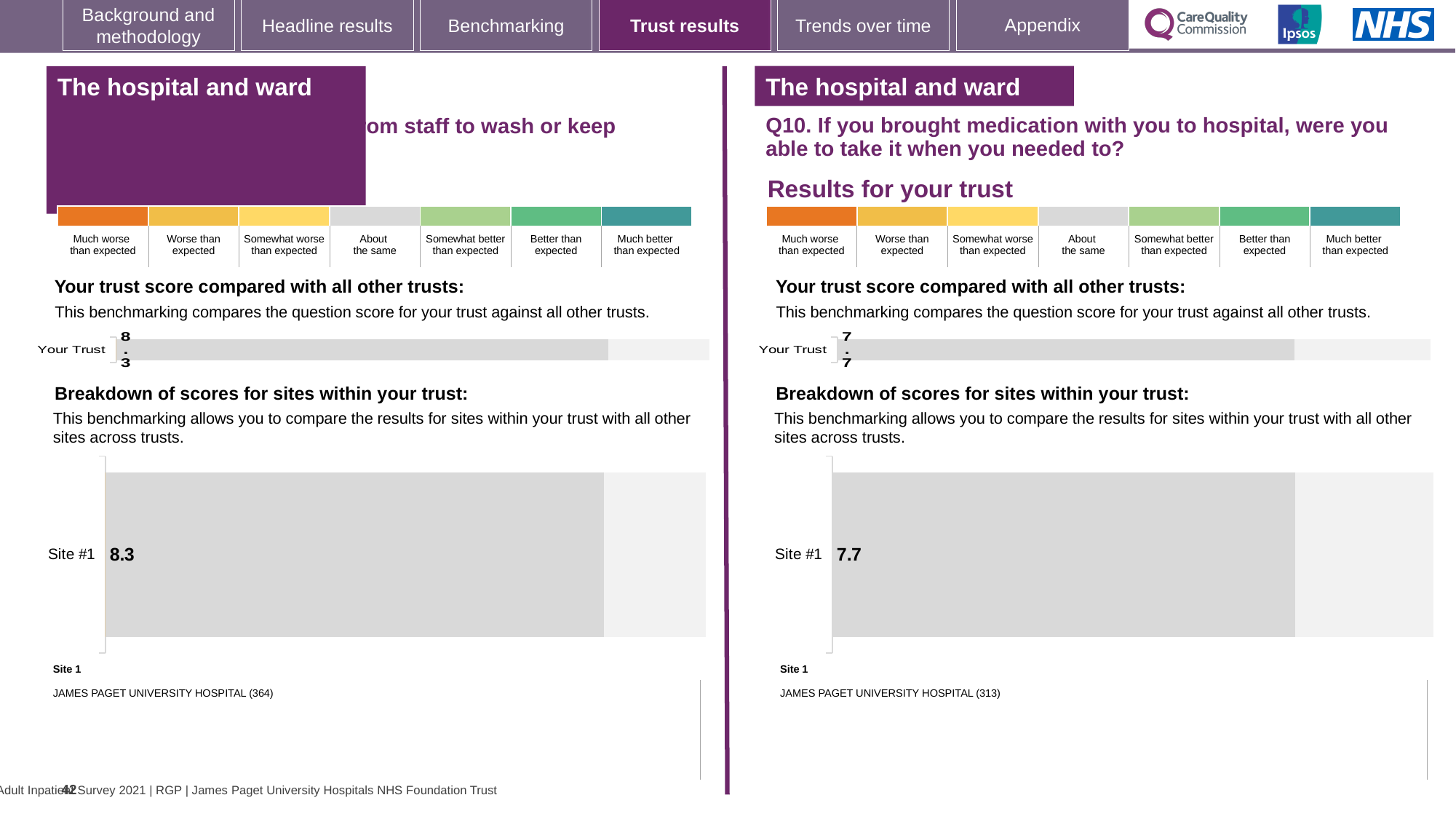
On the right half of the slide (Q10), what is the score shown for Your Trust in the 'Your trust score compared with all other trusts' bar chart? 7.7 Which site name is listed as Site 1 below the breakdown chart on the right half of the slide (Q10)? JAMES PAGET UNIVERSITY HOSPITAL (313) Which site name is listed as Site 1 below the breakdown chart on the left half of the slide? JAMES PAGET UNIVERSITY HOSPITAL (364) What is the difference between the Site #1 score on the left half of the slide (8.3) and the Site #1 score on the right half (7.7)? 0.6 On the left half of the slide, what is the score shown for Your Trust in the 'Your trust score compared with all other trusts' bar chart? 8.3 In the 'Breakdown of scores for sites within your trust' chart on the left half of the slide, what is the score for Site #1? 8.3 In the 'Breakdown of scores for sites within your trust' chart on the right half of the slide (Q10), what is the score for Site #1? 7.7 Which is larger: the Your Trust score on the left half of the slide or the Your Trust score on the right half (Q10)? Left half (8.3) How many sites are shown in the 'Breakdown of scores for sites within your trust' chart on the right half of the slide (Q10)? 1 What type of chart is used to show the Your Trust score on the left half of the slide? Bar chart What type of chart is used to show the Site #1 score on the right half of the slide (Q10)? Bar chart How many sites are shown in the 'Breakdown of scores for sites within your trust' chart on the left half of the slide? 1